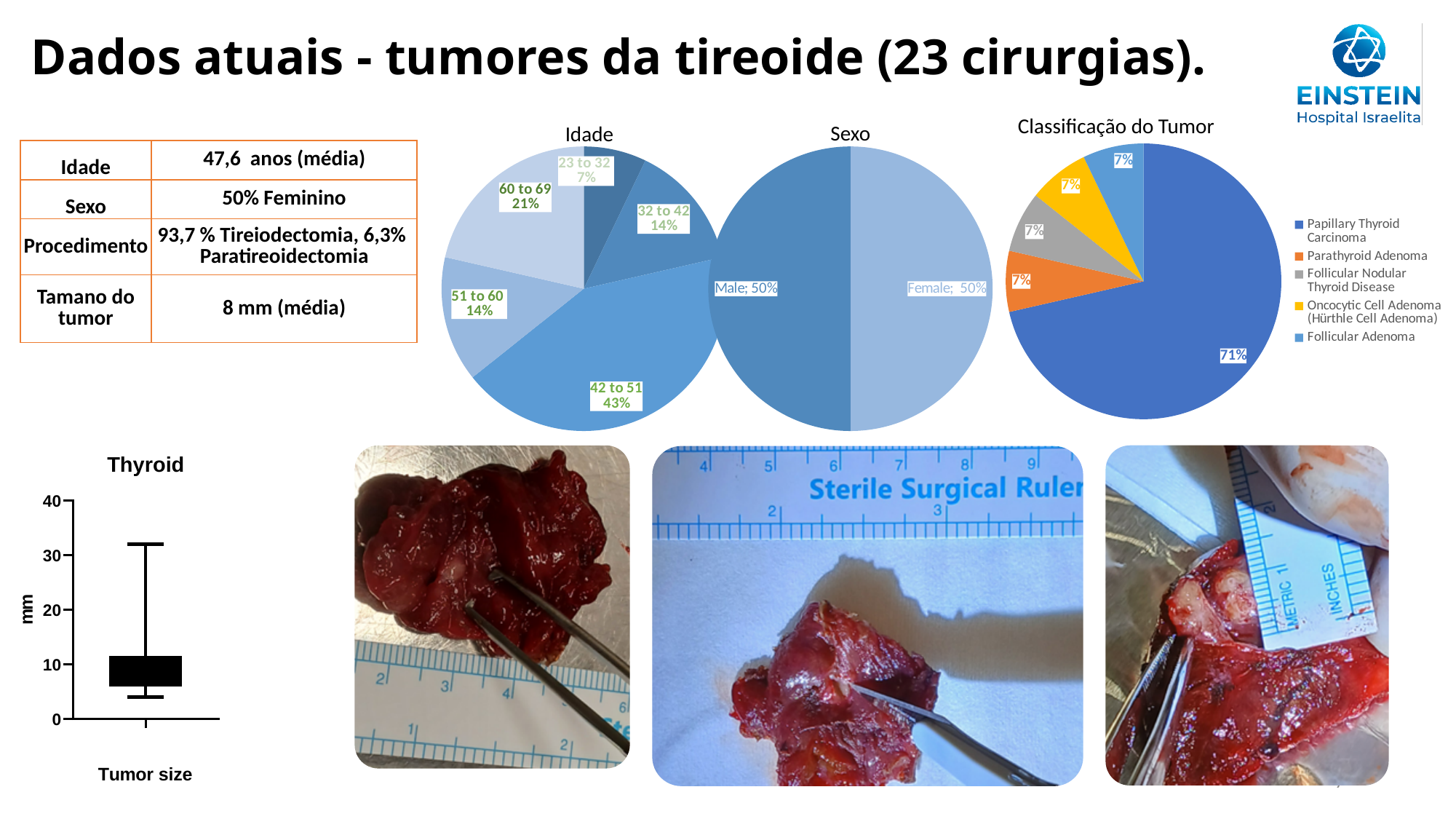
In the 'Classificação do Tumor' pie chart, what share is Parathyroid Adenoma? 7% What kind of chart is the 'Sexo' chart? Pie chart In the 'Idade' pie chart, how many age groups are shown? 5 In the 'Idade' pie chart, which age group has the largest share? 42 to 51 How many entries does the legend of the 'Classificação do Tumor' pie chart list? 5 In the 'Idade' pie chart, what is the difference in percentage points between the '42 to 51' and '60 to 69' groups? 22 In the 'Idade' pie chart, which age group has the smallest share? 23 to 32 In the 'Idade' pie chart, what share is the '42 to 51' age group? 43% In the 'Classificação do Tumor' pie chart, what share is Papillary Thyroid Carcinoma? 71% In the 'Idade' pie chart, what share is the '60 to 69' age group? 21% In the 'Thyroid' box plot, is the top of the upper whisker greater or less than 30 mm? greater In the 'Sexo' pie chart, what share is Male? 50%